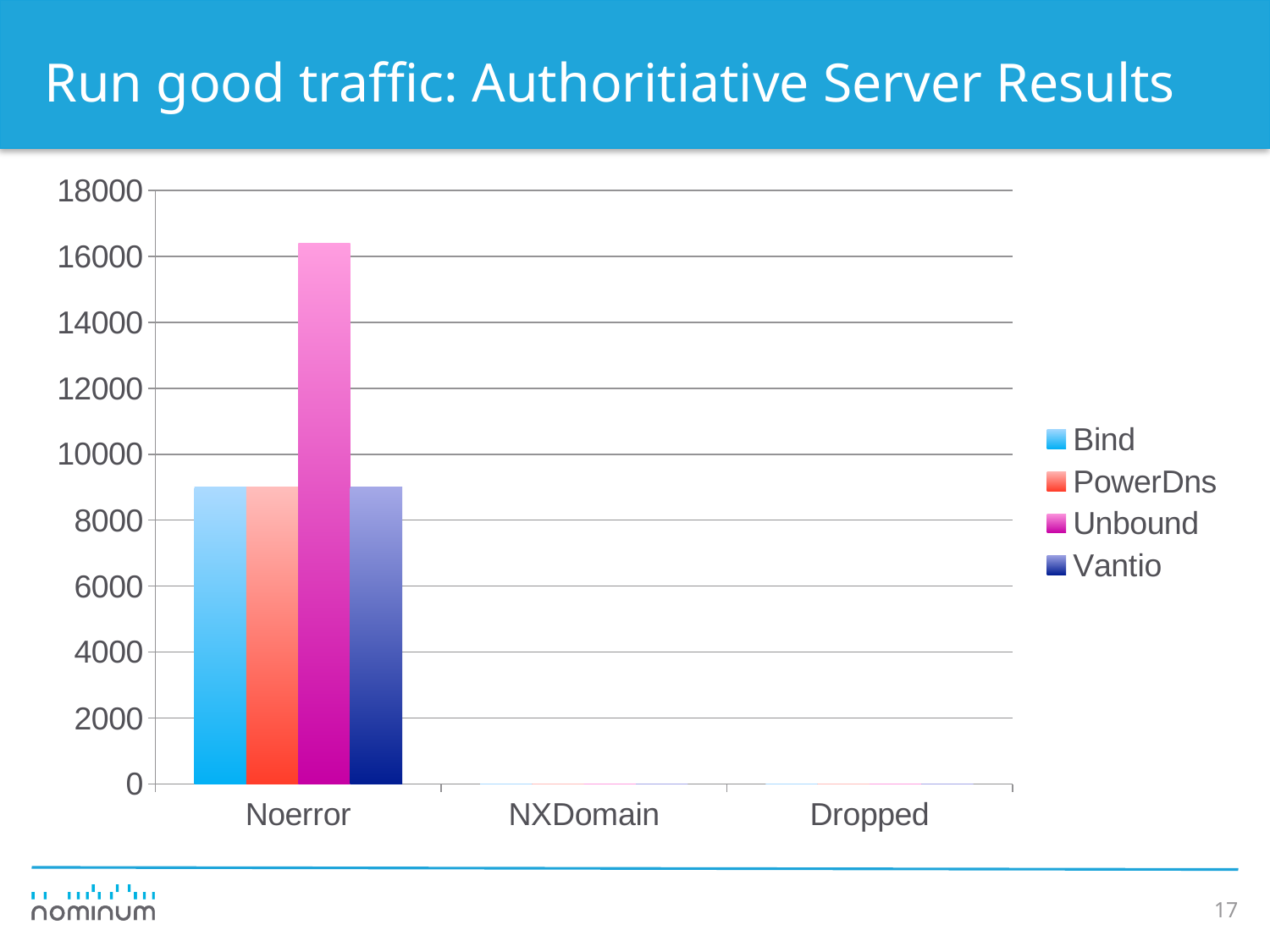
How many categories are shown on the x axis? 3 For the Noerror category, which is larger: the Unbound value or the PowerDns value? Unbound Is the value for Bind in the Noerror category greater or less than 10000? less Is the value for Unbound in the NXDomain category greater or less than 2000? less Which series has the highest value for Noerror? Unbound Is the value for Vantio in the Noerror category greater or less than 8000? greater Which category has the tallest bars overall? Noerror What kind of chart is shown on the slide? bar chart Which series is shown in magenta/pink in the legend? Unbound What is the title of the slide containing the chart? Run good traffic: Authoritiative Server Results How many series does the legend list? 4